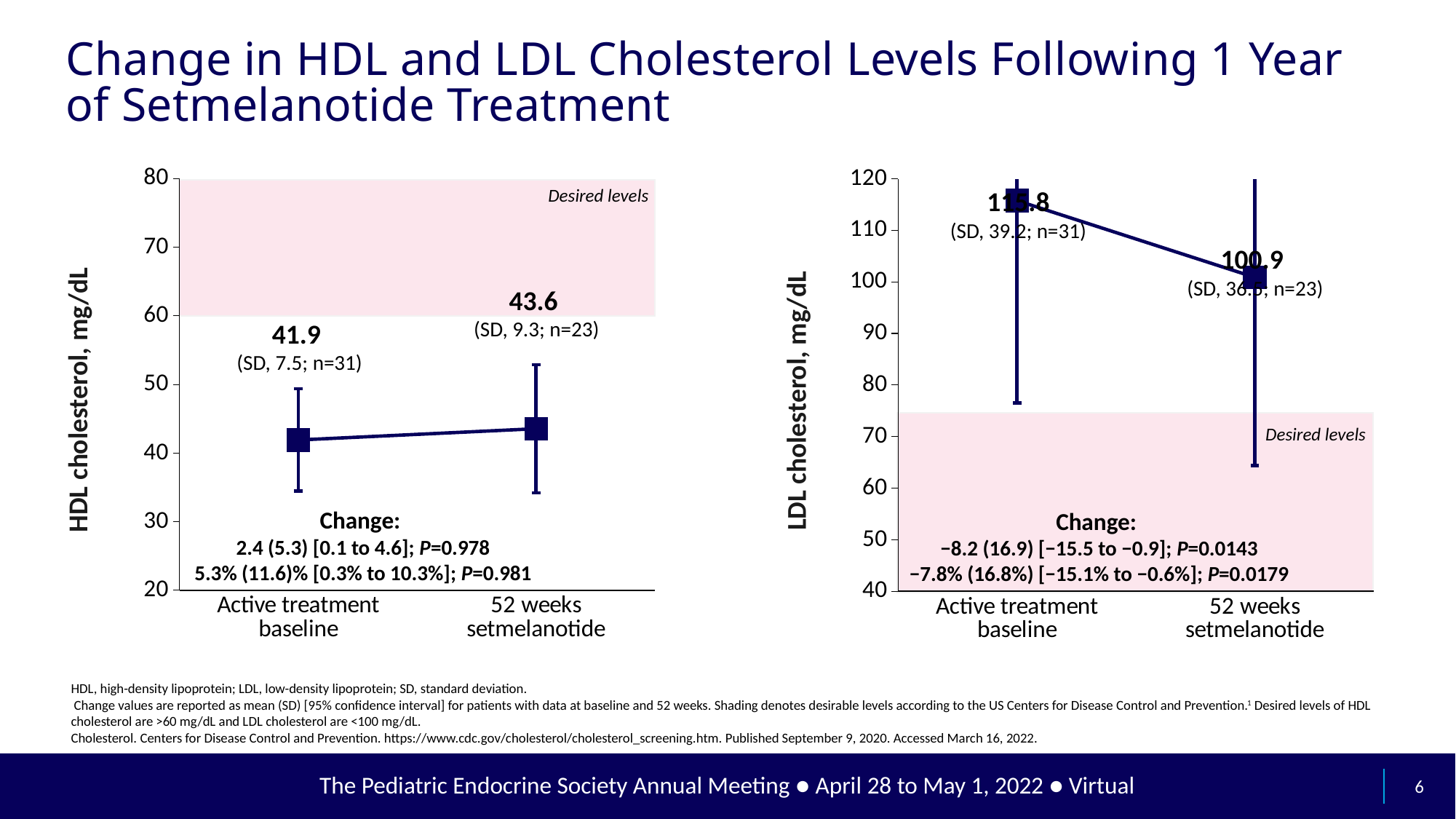
On the HDL cholesterol chart (left), what is the y-axis label? HDL cholesterol, mg/dL How many time points are plotted on the HDL cholesterol chart (left)? 2 On the LDL cholesterol chart (right), what is the difference between the baseline value and the 52-week value? 14.9 On the LDL cholesterol chart (right), what is the mean LDL cholesterol value at active treatment baseline? 115.8 On the HDL cholesterol chart (left), do the mean values rise or fall from baseline to 52 weeks? Rise On the LDL cholesterol chart (right), which time point has the higher mean LDL value? Active treatment baseline On the LDL cholesterol chart (right), what is the mean LDL cholesterol value at 52 weeks setmelanotide? 100.9 On the HDL cholesterol chart (left), which time point has the lower mean HDL value? Active treatment baseline On the HDL cholesterol chart (left), what is the mean HDL cholesterol value at 52 weeks setmelanotide? 43.6 On the HDL cholesterol chart (left), what is the mean HDL cholesterol value at active treatment baseline? 41.9 On the HDL cholesterol chart (left), what is the difference between the 52-week value and the baseline value? 1.7 On the LDL cholesterol chart (right), do the mean values rise or fall from baseline to 52 weeks? Fall